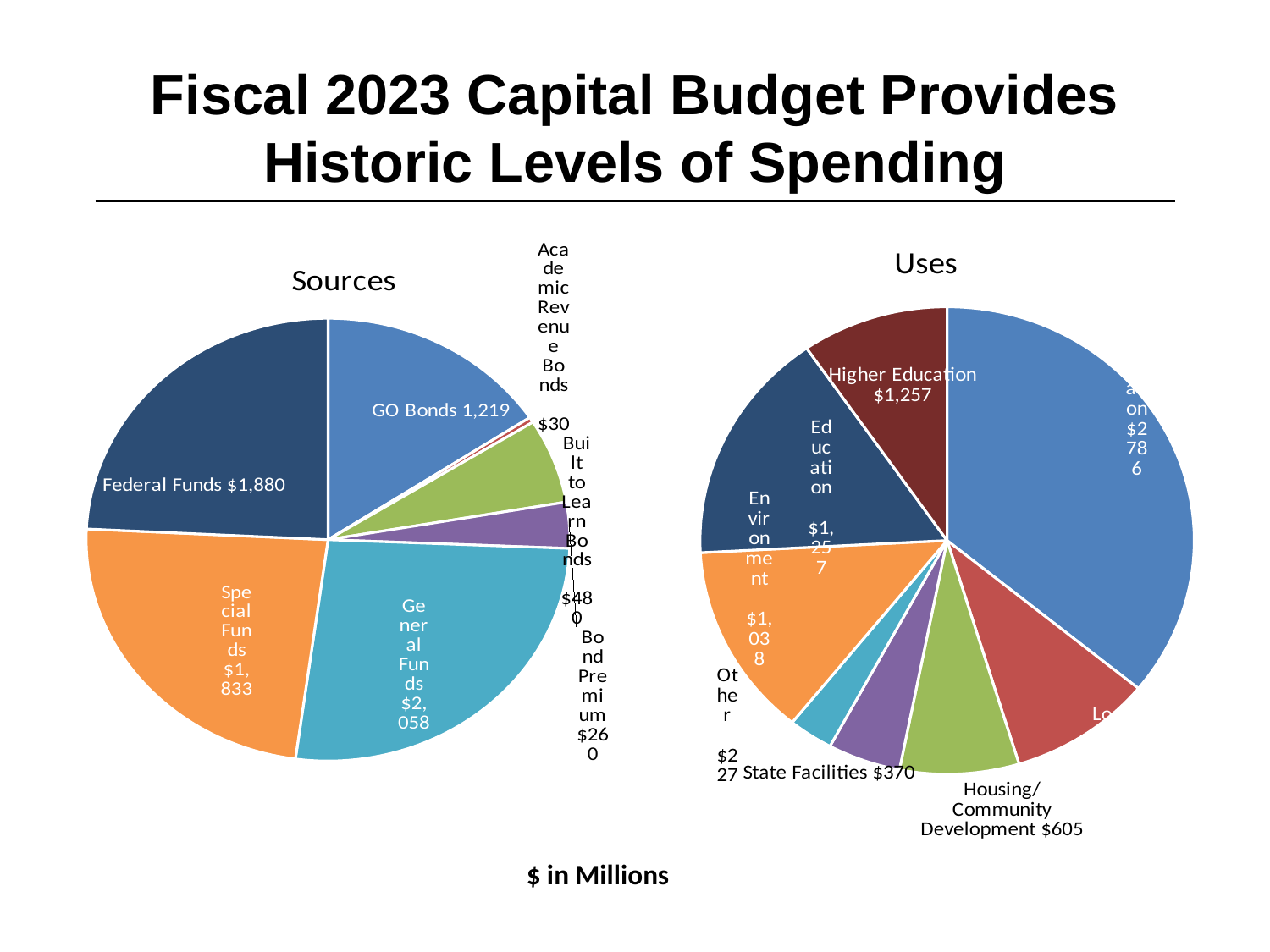
In the Sources chart, what is the value for Federal Funds? $1,880 In the Sources chart, how much larger is Federal Funds than Special Funds? $47 In the Sources chart, what is the value for GO Bonds? 1,219 What unit note is printed below the charts? $ in Millions In the Sources chart, what is the value for General Funds? $2,058 In the Sources chart, what is the value for Special Funds? $1,833 What kind of charts are shown on the slide? Pie charts In the Uses chart, which is larger, Housing/Community Development or State Facilities? Housing/Community Development In the Uses chart, what is the value for State Facilities? $370 In the Sources chart, which source has the smallest slice? Academic Revenue Bonds In the Uses chart, what is the value for Housing/Community Development? $605 In the Sources chart, which source has the largest slice? General Funds